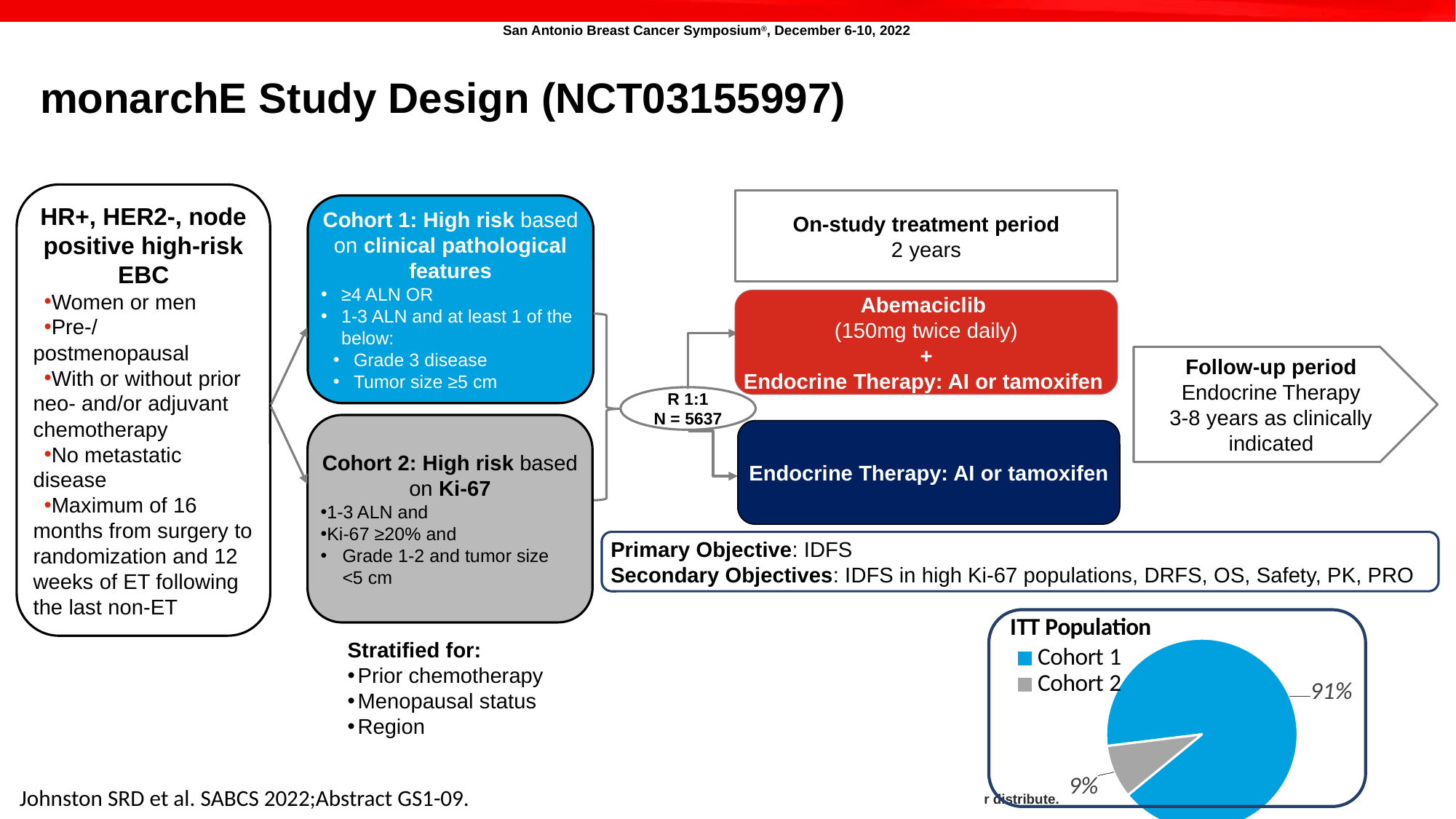
How many entries does the legend of the ITT Population pie chart list? 2 In the ITT Population pie chart, what share does Cohort 1 represent? 91% What kind of chart is the ITT Population chart? pie chart In the ITT Population pie chart, what share does Cohort 2 represent? 9% In the ITT Population pie chart, is the share for Cohort 1 larger or smaller than the share for Cohort 2? larger In the ITT Population pie chart, which colour represents Cohort 2? gray How many slices does the ITT Population pie chart have? 2 Which cohort has the smallest slice in the ITT Population pie chart? Cohort 2 What is the title of the pie chart on the slide? ITT Population Which cohort has the largest slice in the ITT Population pie chart? Cohort 1 In the ITT Population pie chart, what is the difference in percentage points between Cohort 1 and Cohort 2? 82